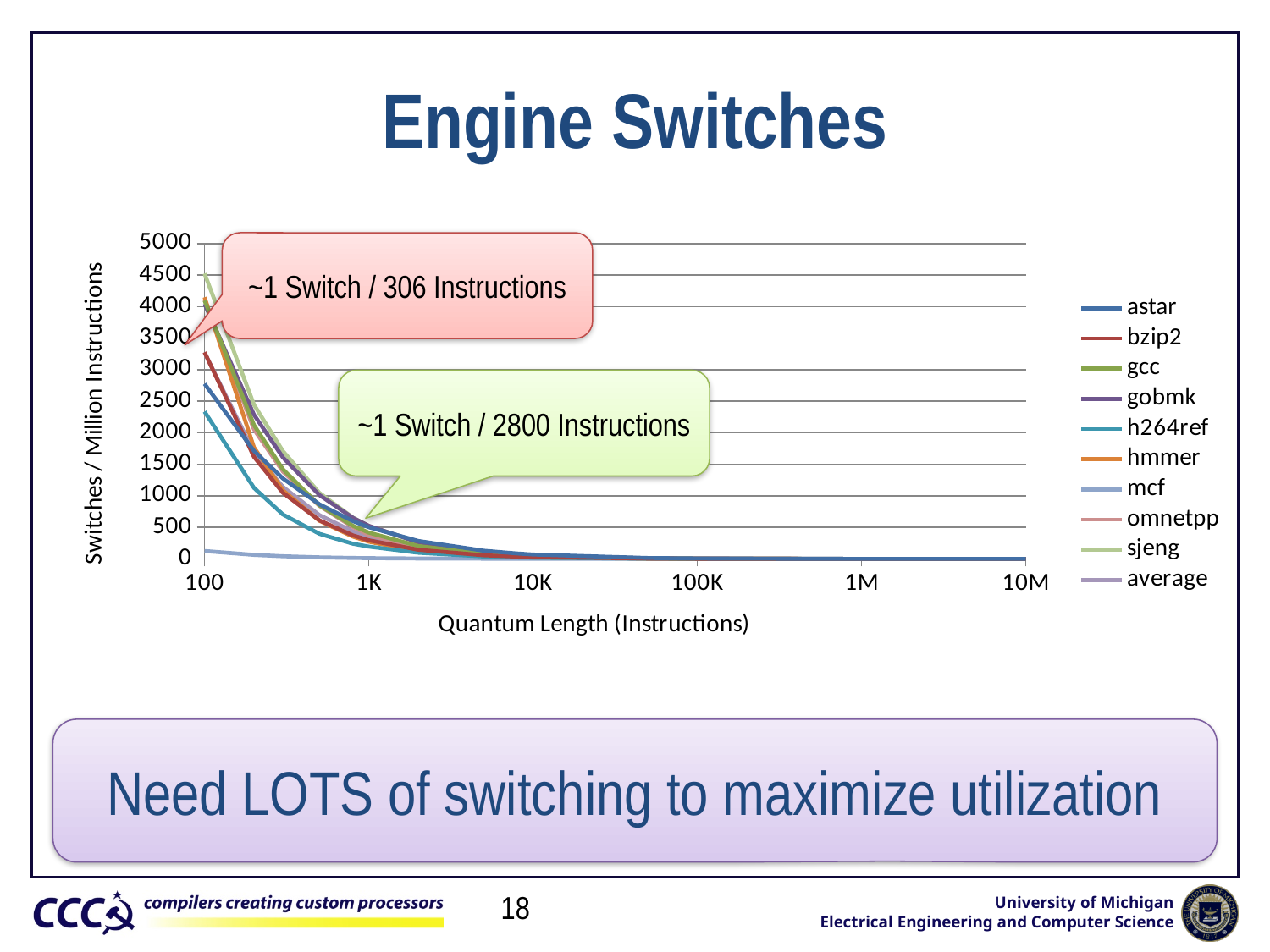
How many series does the legend list? 10 Is the value for h264ref at a quantum length of 100 greater or less than 2500? less At a quantum length of 100, which is larger, the value for astar or the value for h264ref? astar Do the values for the benchmarks rise or fall as quantum length increases along the x axis? fall What is the title of the chart's x axis? Quantum Length (Instructions) Which series has the lowest value at a quantum length of 100? mcf What kind of chart is shown on the slide? line chart At a quantum length of 100, which is larger, the value for mcf or the value for astar? astar What is the title of the chart's y axis? Switches / Million Instructions Is the value for mcf at a quantum length of 100 greater or less than 500? less Is the value for astar at a quantum length of 100 greater or less than 2500? greater